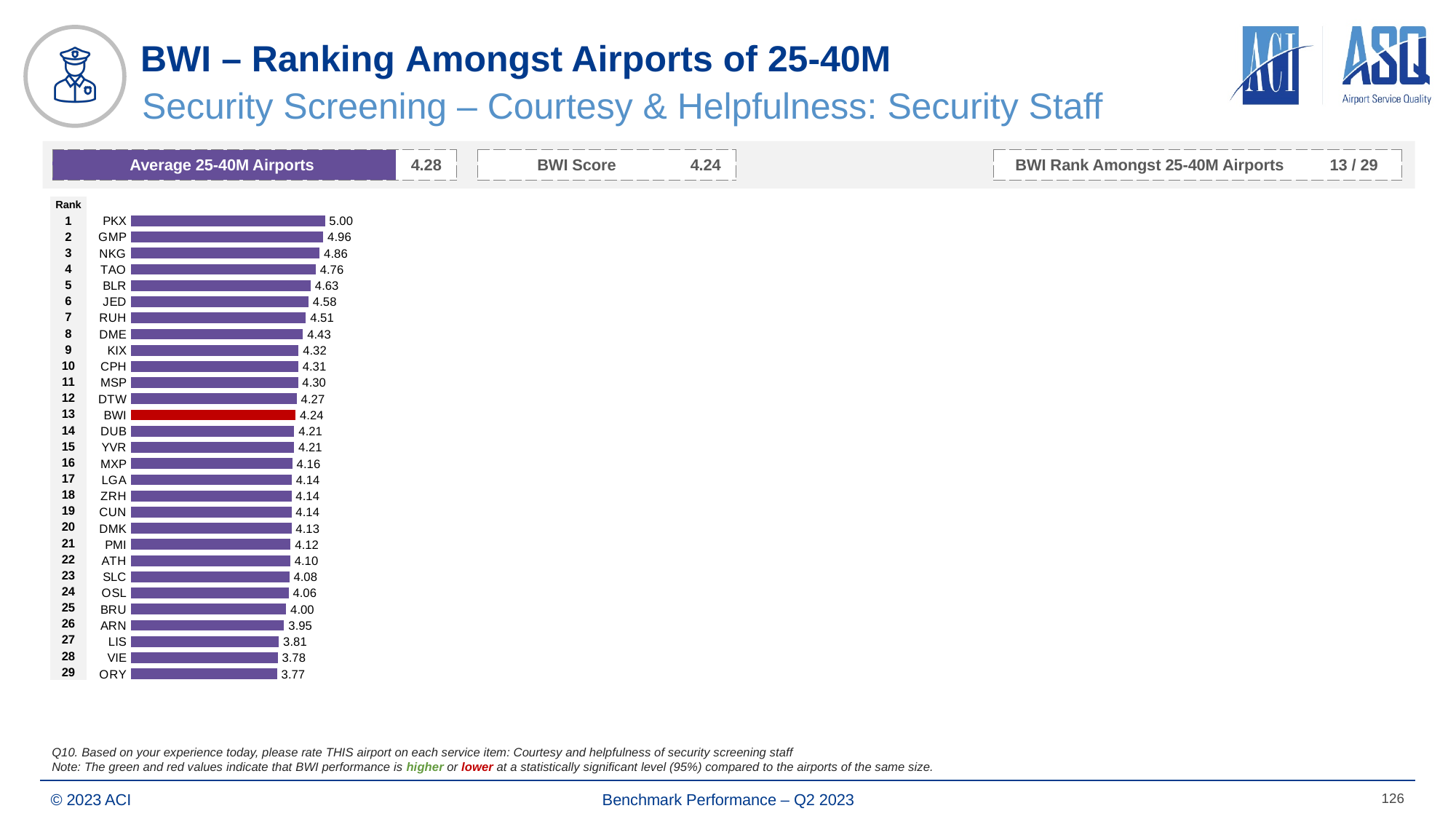
What is the difference between the values for PKX and ORY? 1.23 What is the value for ORY in the bar chart? 3.77 What is the value for PKX in the bar chart? 5.00 Which airport has the highest value in the bar chart? PKX What kind of chart is shown on the slide? Bar chart How many airports are shown in the bar chart? 29 What is the difference between the values for DTW and BWI? 0.03 Which airport has the lowest value in the bar chart? ORY What is the value for BWI in the bar chart? 4.24 What is the rank of BWI amongst 25-40M airports shown on the slide? 13 / 29 Which has a larger value, GMP or NKG? GMP Which bar in the chart is coloured red? BWI